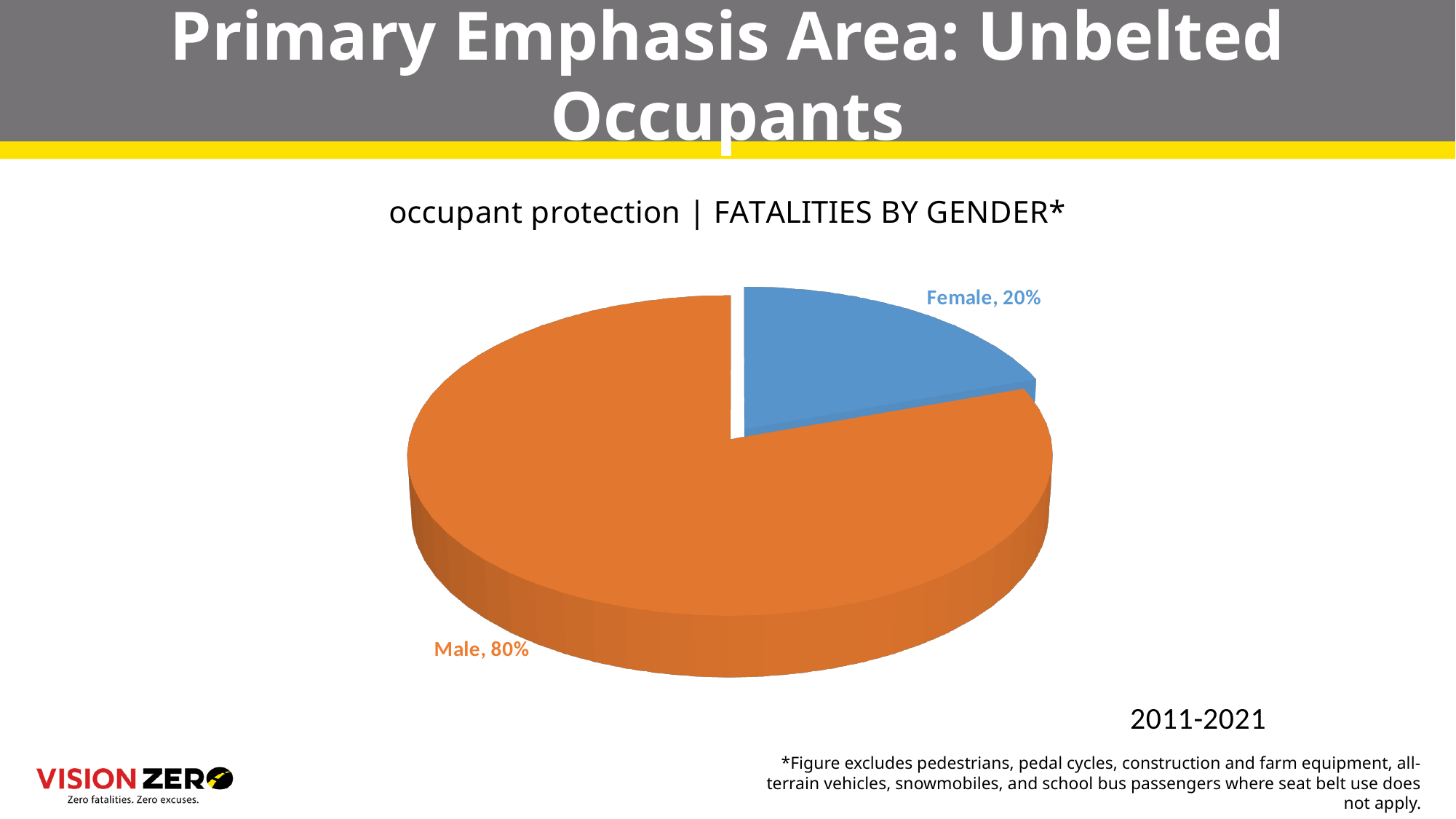
What share of unbelted occupant fatalities were male? 80% What kind of chart is shown on the slide? Pie chart What colour is the Female slice of the pie chart? Blue Which is larger, the male share or the female share of fatalities? Male What is the difference in percentage points between the male and female shares of fatalities? 60 What share of unbelted occupant fatalities were female? 20% Which gender accounts for the smallest share of fatalities in the pie chart? Female Which gender accounts for the largest share of fatalities in the pie chart? Male What is the title of the chart? occupant protection | FATALITIES BY GENDER* What time period does the chart cover? 2011-2021 How many slices does the pie chart have? 2